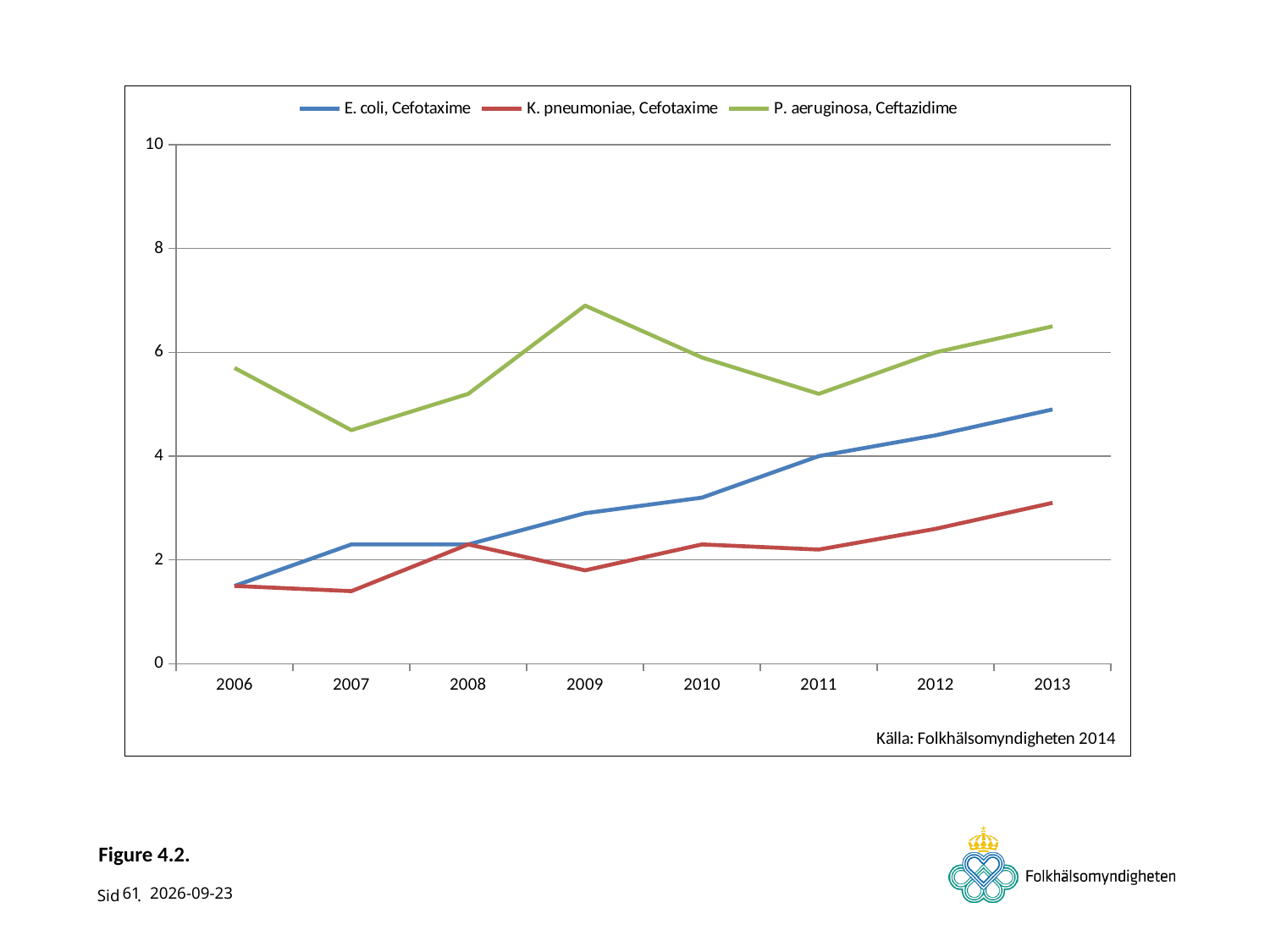
Is the value for K. pneumoniae, Cefotaxime in 2009 greater or less than 2? less How many years are shown on the x axis? 8 In which year is the P. aeruginosa, Ceftazidime line at its lowest? 2007 Is the value for P. aeruginosa, Ceftazidime in 2009 greater or less than 6? greater What source is cited at the bottom of the chart? Källa: Folkhälsomyndigheten 2014 Is the value for E. coli, Cefotaxime in 2013 greater or less than 4? greater In which year does the E. coli, Cefotaxime line reach its highest value? 2013 In which year does the P. aeruginosa, Ceftazidime line reach its highest value? 2009 How many series does the legend list? 3 Does the E. coli, Cefotaxime line generally rise or fall from 2006 to 2013? rise In 2013, which series has the larger value: E. coli, Cefotaxime or K. pneumoniae, Cefotaxime? E. coli, Cefotaxime What kind of chart is shown on the slide? line chart